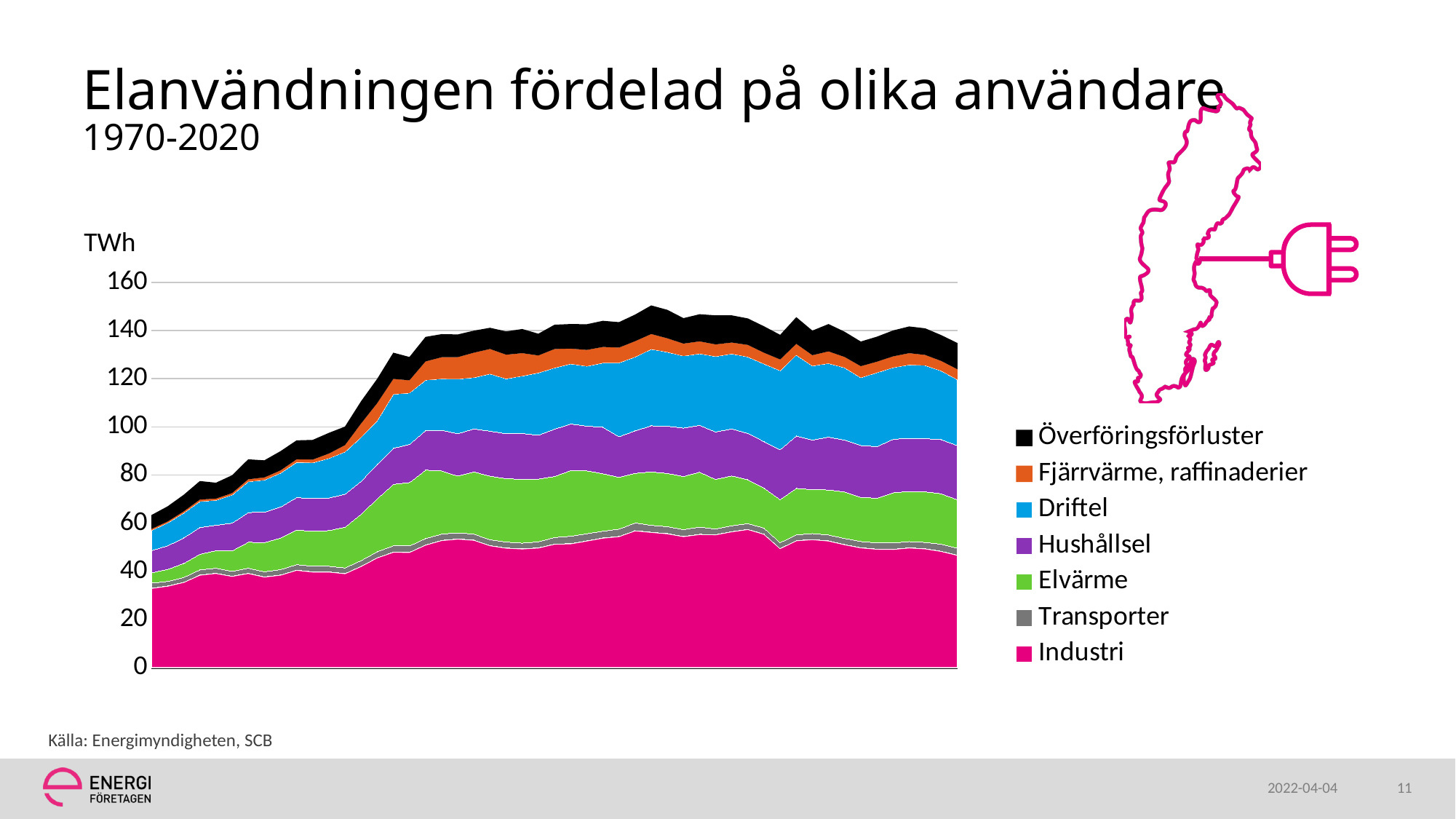
How many series does the legend list? 7 Does the total electricity use rise or fall from 1970 to around 1990? rise What unit is shown on the y axis? TWh Which series is the thinnest band in the stacked area chart? Transporter What kind of chart is shown on the slide? Stacked area chart Is the value for Industri at the end of the period (2020) greater or less than 60 TWh? less What is the title of the chart? Elanvändningen fördelad på olika användare 1970-2020 Which series is the largest band in the stacked area chart? Industri Is the highest total electricity use reached in the chart greater or less than 140 TWh? greater Is the total electricity use at the start of the period (1970) greater or less than 80 TWh? less Which series is larger at the end of the period, Driftel or Transporter? Driftel